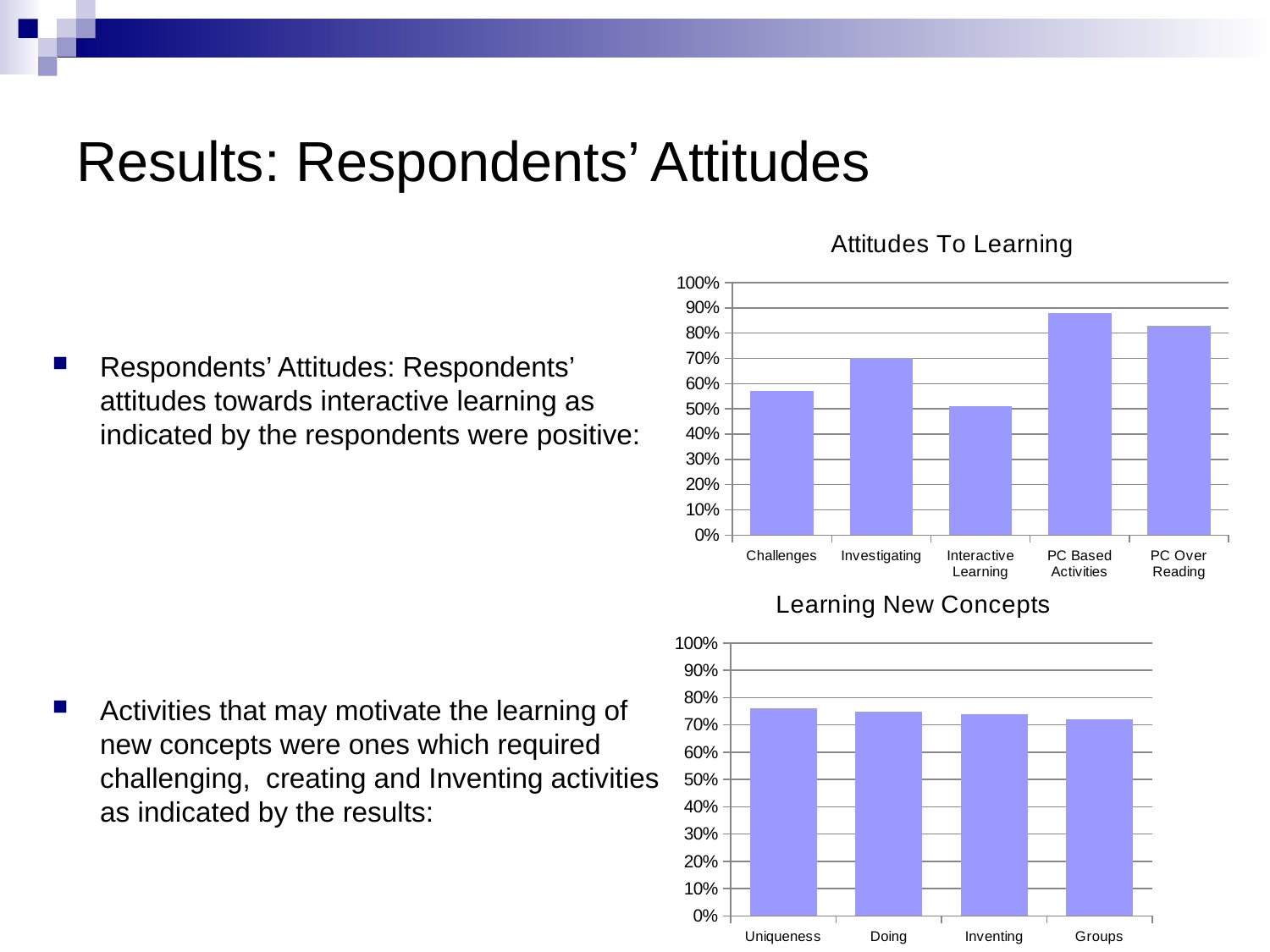
How many categories are shown in the 'Attitudes To Learning' chart? 5 In the 'Attitudes To Learning' chart, is the value for PC Based Activities greater or less than 80%? greater In the 'Attitudes To Learning' chart, is the value for Challenges greater or less than 60%? less What is the title of the lower chart on the slide? Learning New Concepts In the 'Attitudes To Learning' chart, is the value for PC Over Reading greater or less than 70%? greater In the 'Attitudes To Learning' chart, which category has the highest value? PC Based Activities In the 'Attitudes To Learning' chart, which category has the lowest value? Interactive Learning What kind of chart is the 'Attitudes To Learning' chart? bar chart In the 'Learning New Concepts' chart, do the values rise or fall from Uniqueness to Groups along the x axis? fall In the 'Attitudes To Learning' chart, which is larger: the value for Investigating or the value for Interactive Learning? Investigating How many categories are shown in the 'Learning New Concepts' chart? 4